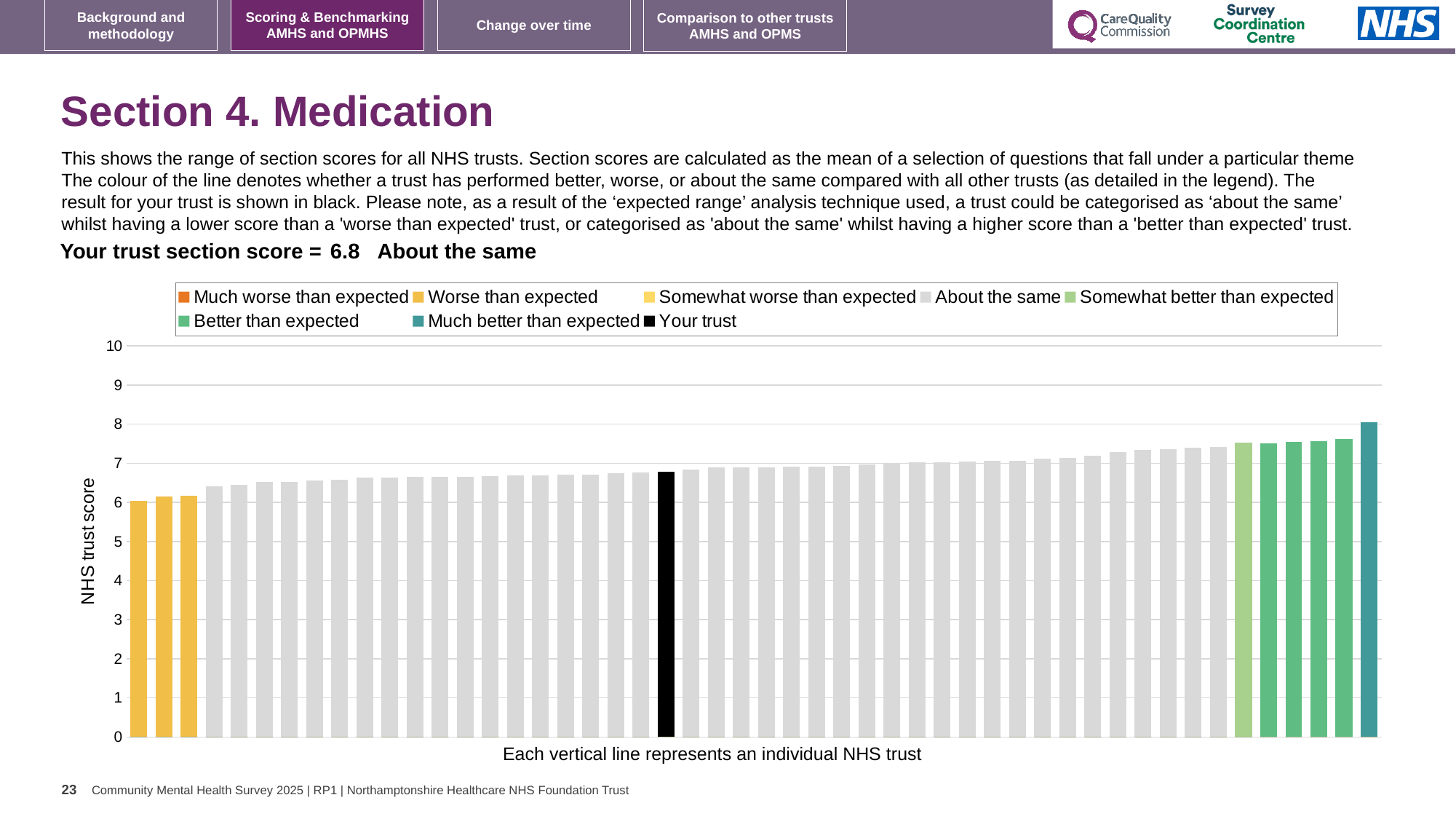
What kind of chart is shown on the slide? bar chart How many bars are coloured as 'Much better than expected'? 1 How many entries does the chart legend list? 8 Is the value of the shortest bar (the leftmost trust) greater or less than 5? greater Which performance category is your trust's section score placed in? About the same What is the section score for your trust shown on the slide? 6.8 How many bars are coloured as 'Better than expected'? 4 Do the bar values rise or fall from left to right along the x axis? rise What is the label on the vertical axis of the chart? NHS trust score How many bars are coloured as 'Worse than expected'? 3 Is the value of the tallest bar (the rightmost trust) greater or less than 7? greater Is the value for your trust (the black bar) greater or less than 7? less